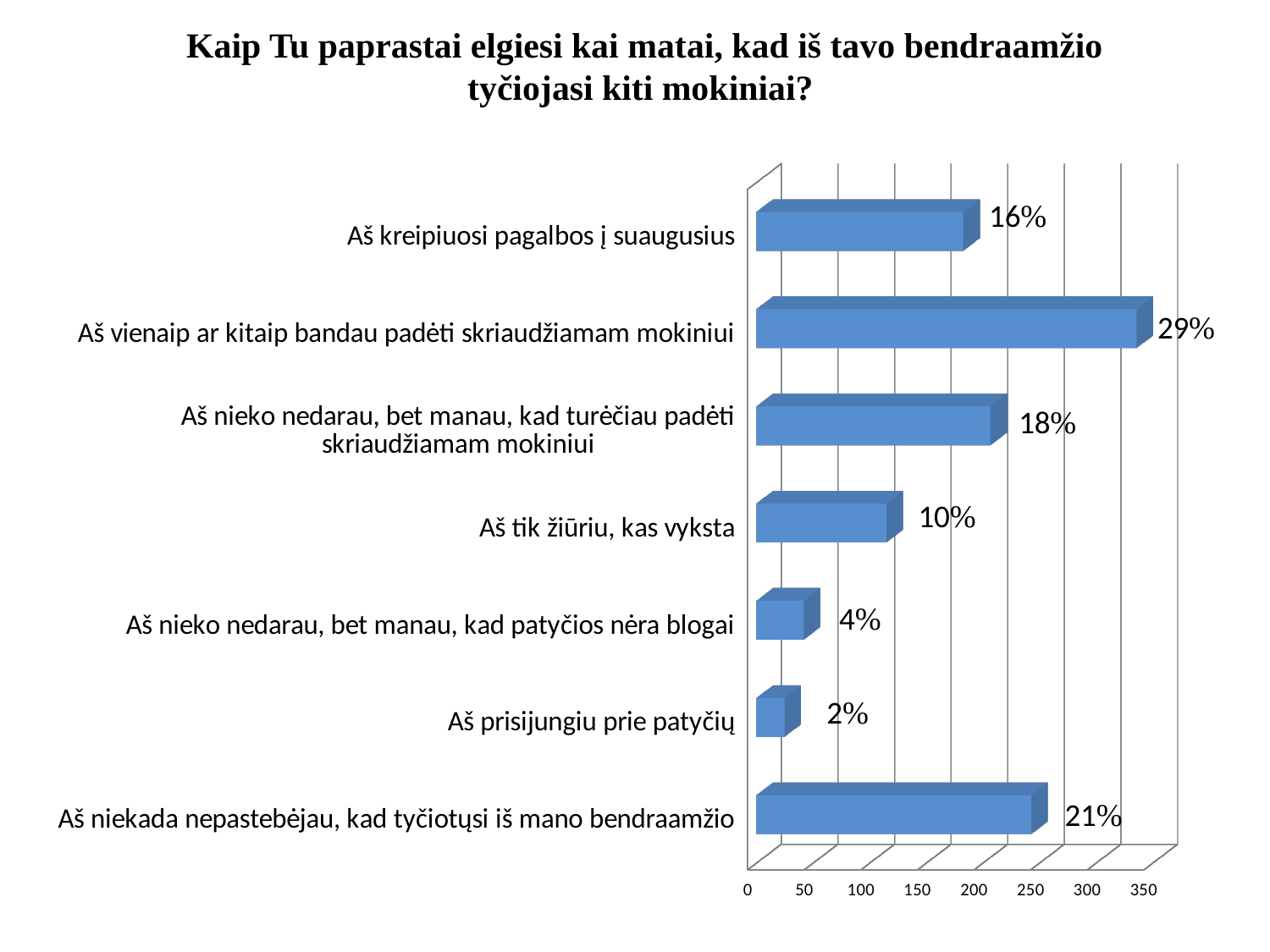
Which is larger: "Aš tik žiūriu, kas vykta" or "Aš nieko nedarau, bet manau, kad turėčiau padėti skriaudžiamam mokiniui"? Aš nieko nedarau, bet manau, kad turėčiau padėti skriaudžiamam mokiniui What is the data label for "Aš kreipiuosi pagalbos į suaugusius"? 16% Is the bar for "Aš niekada nepastebėjau, kad tyčiotųsi iš mano bendraamžio" greater or less than 200 on the axis? greater What is the data label for "Aš prisijungiu prie patyčių"? 2% What kind of chart is shown on the slide? Bar chart Which category has the lowest value? Aš prisijungiu prie patyčių What is the data label for "Aš niekada nepastebėjau, kad tyčiotųsi iš mano bendraamžio"? 21% Which category has the highest value? Aš vienaip ar kitaip bandau padėti skriaudžiamam mokiniui What is the maximum value shown on the horizontal axis? 350 What is the difference in percentage points between "Aš vienaip ar kitaip bandau padėti skriaudžiamam mokiniui" and "Aš kreipiuosi pagalbos į suaugusius"? 13% How many categories are shown in the chart? 7 Is the bar for "Aš kreipiuosi pagalbos į suaugusius" greater or less than 150 on the axis? greater